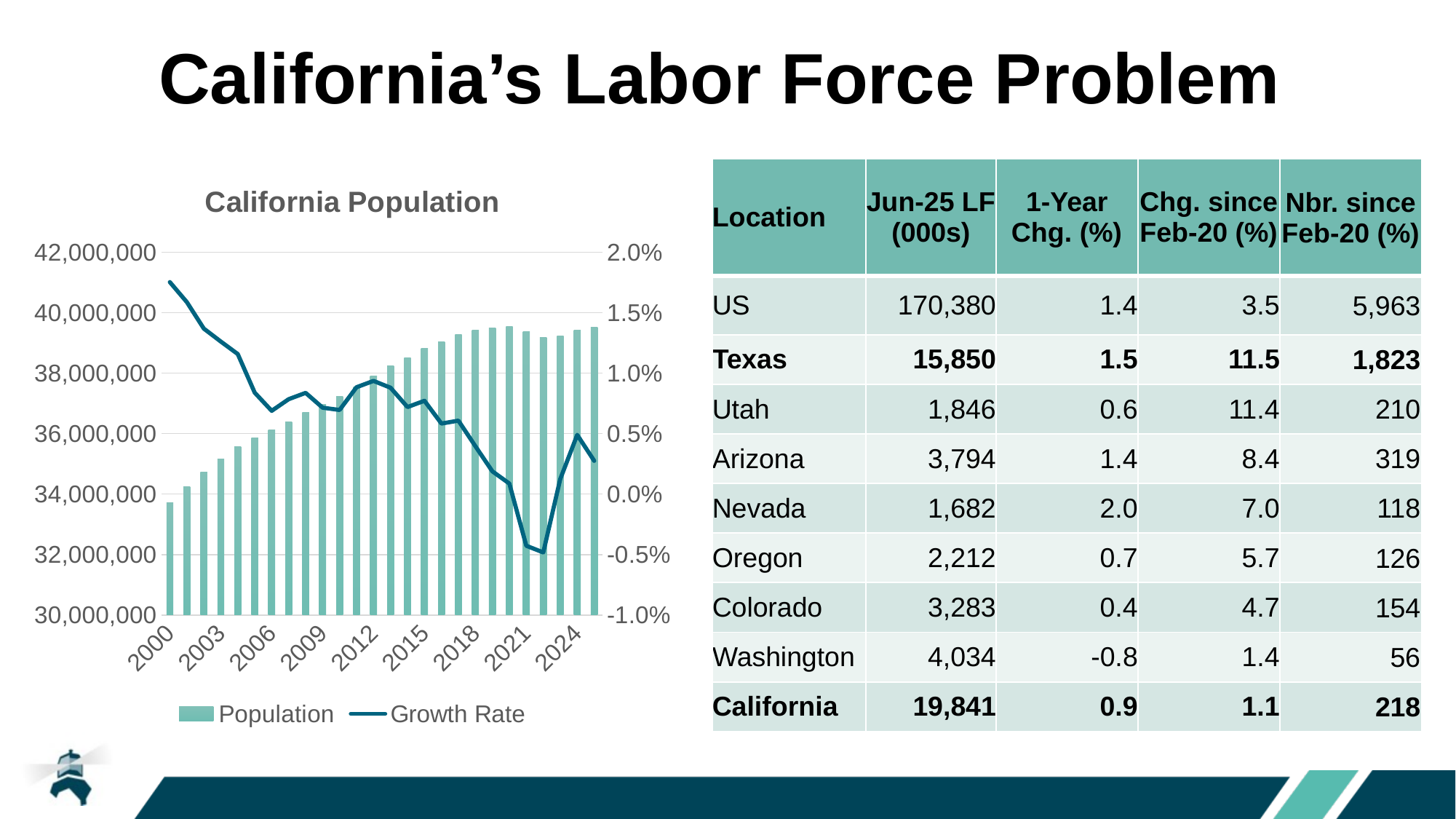
What is the title of the chart on the slide? California Population What kind of chart is the California Population chart? A combined bar and line chart Which year has the highest Growth Rate in the chart? 2000 Which year has the higher Population, 2000 or 2024? 2024 Is the Growth Rate value for 2021 greater or less than 0.0%? less Is the Growth Rate value for 2000 greater or less than 1.5%? greater Is the Population value for 2024 greater or less than 38,000,000? greater Which series in the California Population chart is drawn as a line? Growth Rate Do the Population bars generally rise or fall from 2000 to 2018? rise How many series does the legend of the California Population chart list? 2 Does the Growth Rate line rise or fall from 2000 to 2006? fall